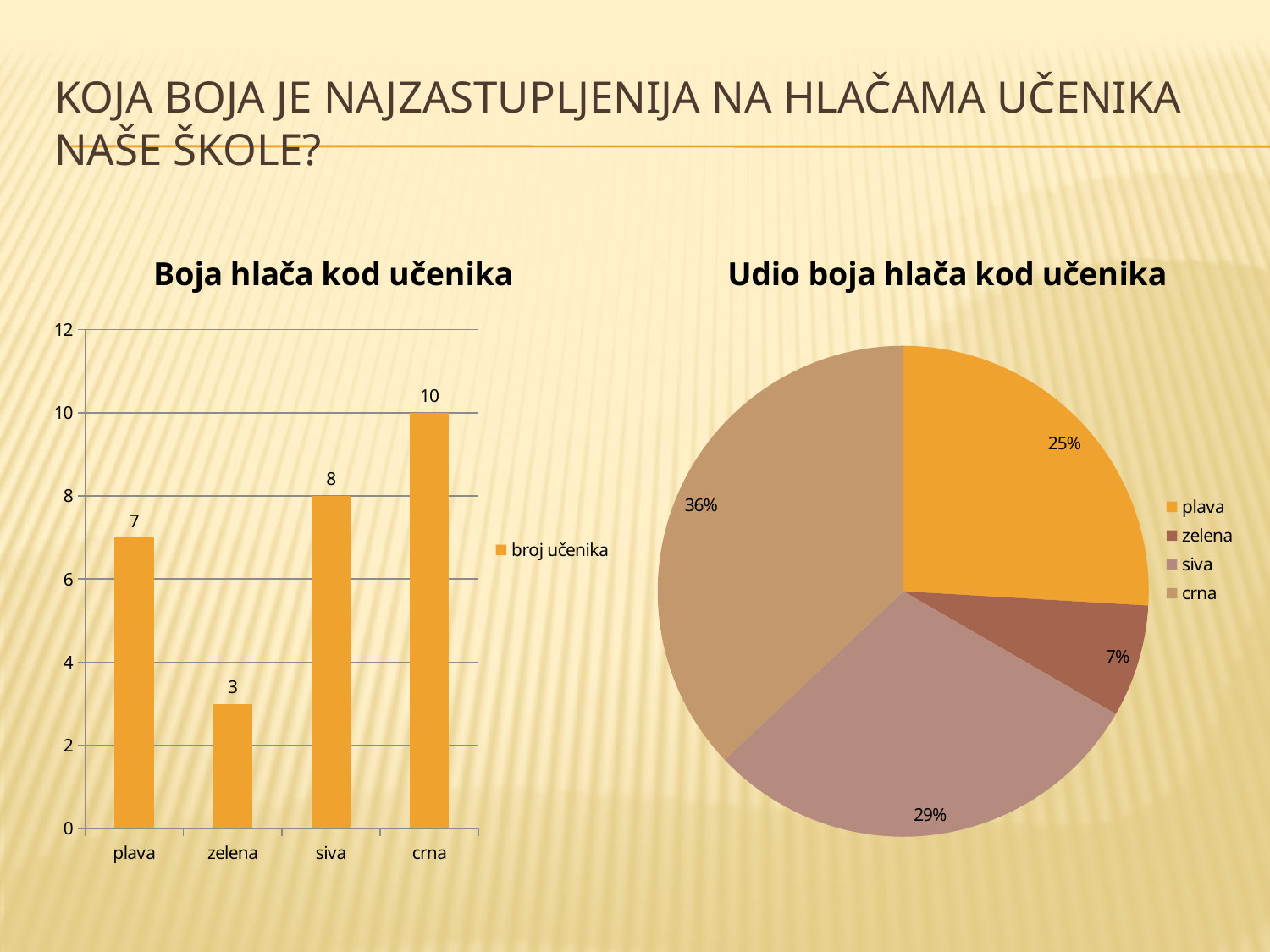
In the 'Boja hlača kod učenika' chart, what is the difference between the values for crna and plava? 3 In the 'Boja hlača kod učenika' chart, what is the value for crna? 10 In the 'Boja hlača kod učenika' chart, which category has the highest value? crna What kind of chart is 'Boja hlača kod učenika'? bar chart In the 'Udio boja hlača kod učenika' chart, what share does siva have? 29% What is the legend entry of the 'Boja hlača kod učenika' chart? broj učenika In the 'Udio boja hlača kod učenika' chart, which slice is the smallest? zelena How many entries does the legend of the 'Udio boja hlača kod učenika' chart list? 4 In the 'Boja hlača kod učenika' chart, how many categories are shown on the x axis? 4 In the 'Boja hlača kod učenika' chart, what is the value for zelena? 3 In the 'Boja hlača kod učenika' chart, which category has the lowest value? zelena In the 'Boja hlača kod učenika' chart, which is larger, the value for siva or the value for plava? siva